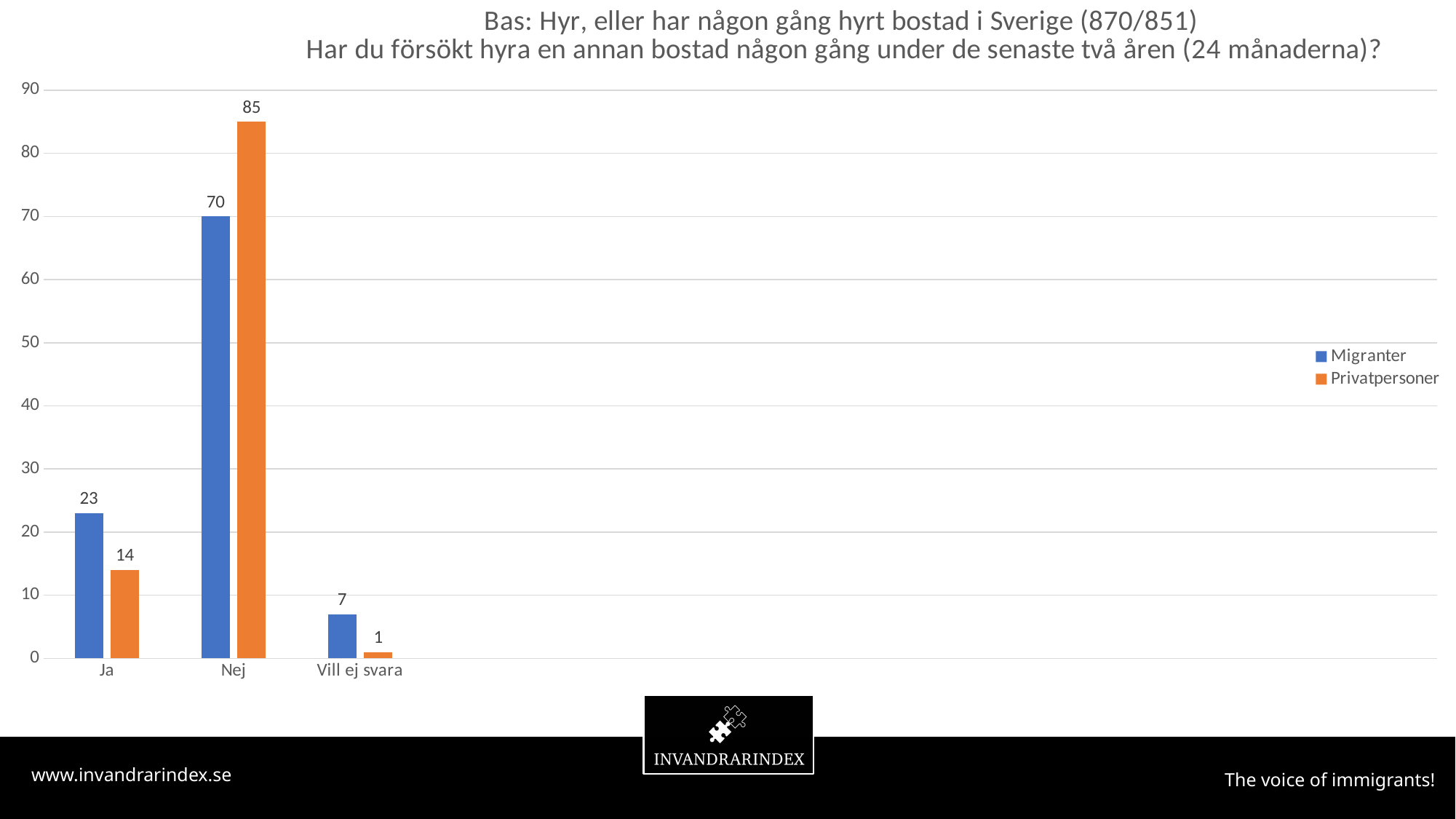
Which category has the lowest value for Privatpersoner? Vill ej svara What is the value for Privatpersoner in the Vill ej svara category? 1 Which series has the larger value in the Ja category, Migranter or Privatpersoner? Migranter How many categories are shown on the x axis? 3 How many series does the legend list? 2 What is the difference between Privatpersoner and Migranter in the Nej category? 15 What kind of chart is shown on the slide? Bar chart What is the difference between Migranter and Privatpersoner in the Ja category? 9 Which colour represents the Privatpersoner series? Orange What is the value for Migranter in the Ja category? 23 Which category has the highest value for Migranter? Nej What is the value for Privatpersoner in the Nej category? 85